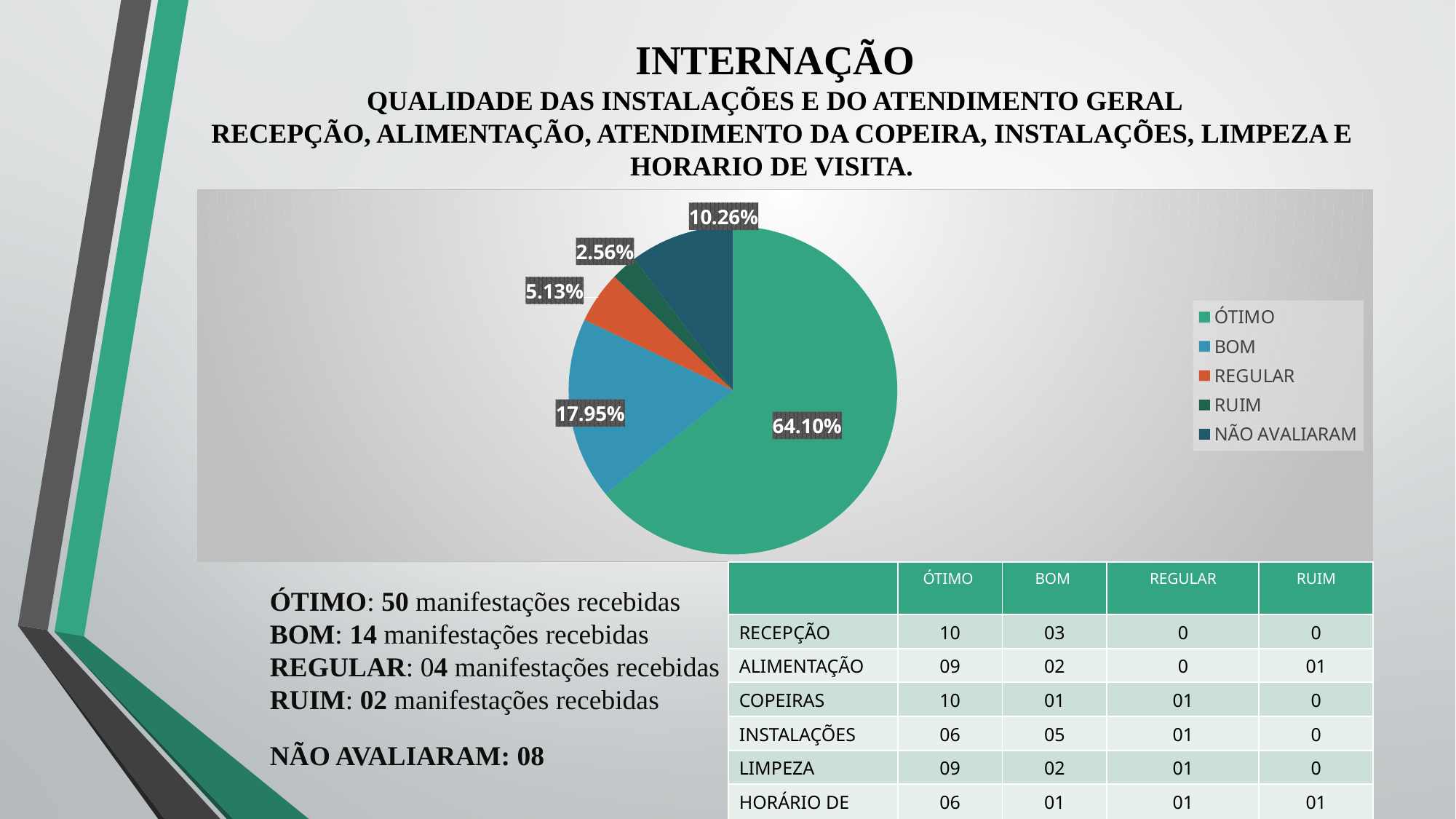
Which slice is larger in the pie chart, BOM or NÃO AVALIARAM? BOM Which category has the largest slice of the pie chart? ÓTIMO What percentage of the pie chart is NÃO AVALIARAM? 10.26% How many entries does the legend of the pie chart list? 5 What percentage of the pie chart is RUIM? 2.56% What percentage of the pie chart is ÓTIMO? 64.10% What kind of chart is shown on the slide? pie chart What is the difference in percentage points between the ÓTIMO and BOM slices? 46.15 Which category has the smallest slice of the pie chart? RUIM What percentage of the pie chart is BOM? 17.95% How many slices does the pie chart have? 5 What percentage of the pie chart is REGULAR? 5.13%